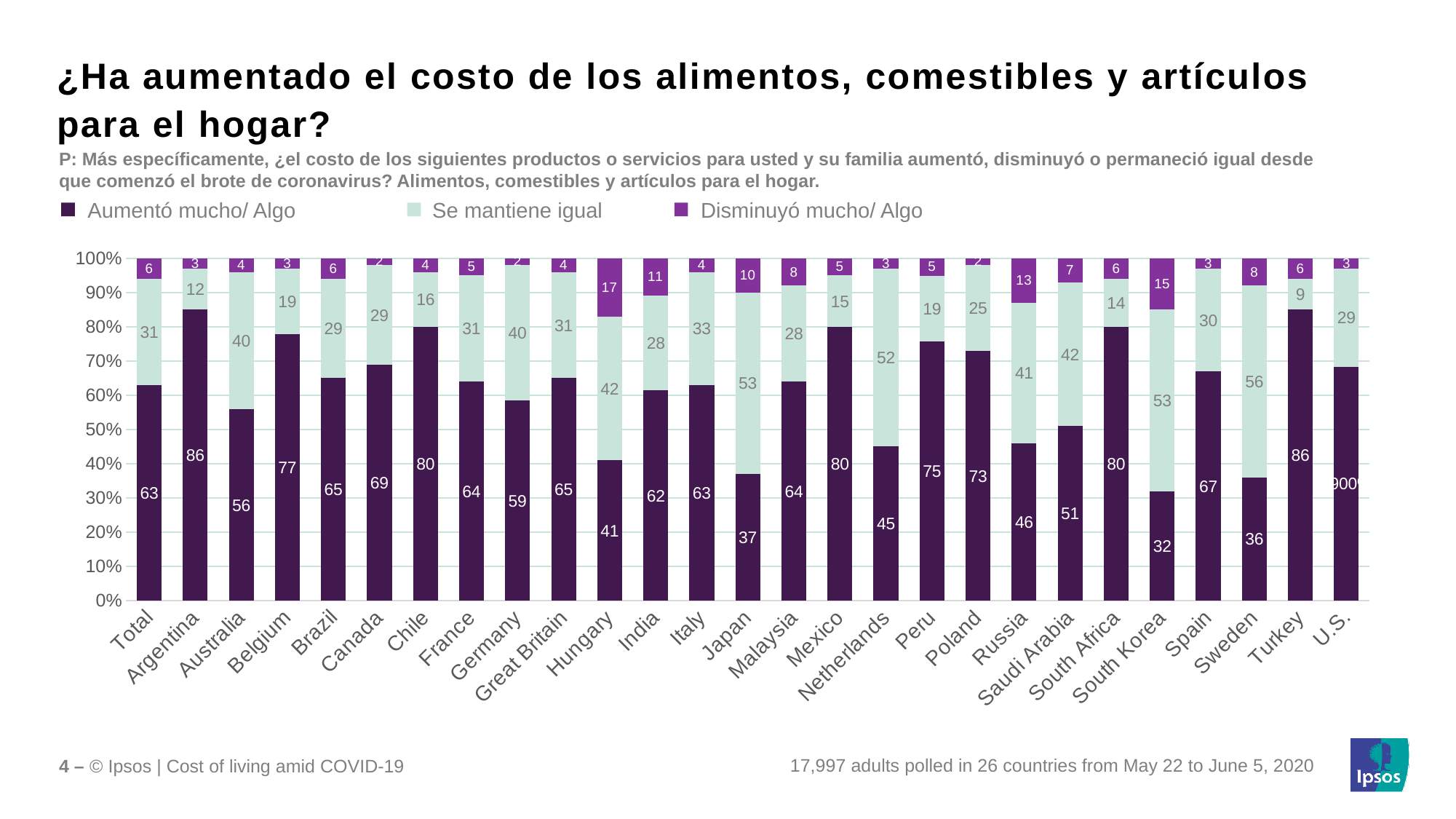
What percentage of respondents in Hungary said the cost increased (Aumentó mucho/ Algo)? 41 What kind of chart is shown on the slide? Stacked bar chart How many series does the legend list? 3 What is the 'Aumentó mucho/ Algo' value for the Total category? 63 Which has a larger 'Aumentó mucho/ Algo' value, Peru or Poland? Peru Which country has the highest value for 'Disminuyó mucho/ Algo'? Hungary Which country has the lowest value for 'Aumentó mucho/ Algo'? South Korea What is the difference between the 'Aumentó mucho/ Algo' values for Chile and Germany? 21 What is the value of the 'Disminuyó mucho/ Algo' segment for Russia? 13 What is the value of the 'Se mantiene igual' segment for Japan? 53 Which country has the highest value for 'Se mantiene igual'? Sweden How many categories are shown on the x axis? 27